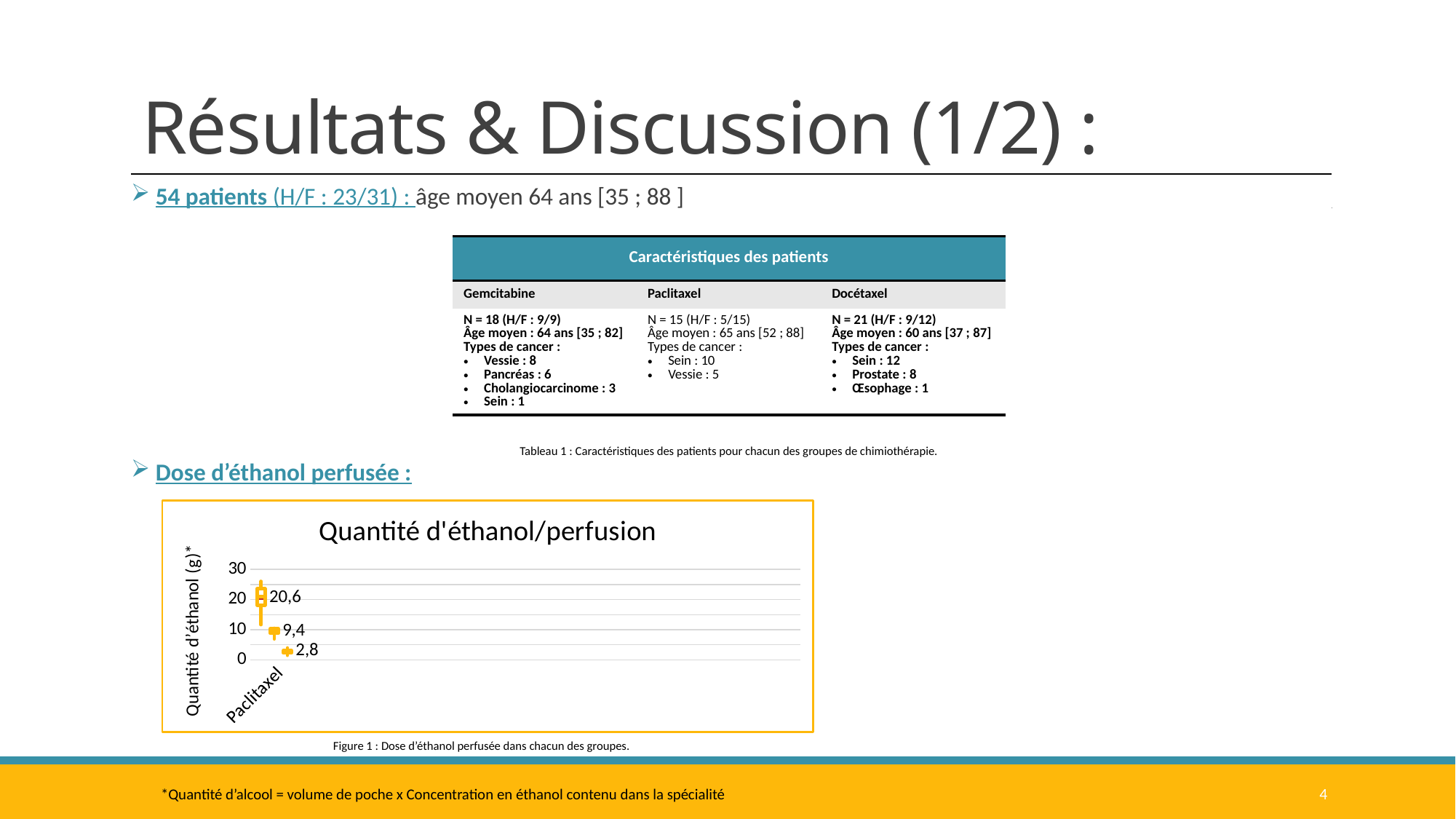
What is the difference between the labeled values of the middle box (9,4) and the rightmost box (2,8)? 6,6 Which box has the larger labeled value, the leftmost box or the rightmost box? The leftmost box How many boxes are plotted in the chart? 3 What value is labeled on the middle box of the chart? 9,4 What is the highest value labeled on the chart? 20,6 What kind of chart is shown on the slide? Box plot What is the label of the y axis of the chart? Quantité d'éthanol (g)* What is the lowest value labeled on the chart? 2,8 What value is labeled on the leftmost box of the chart? 20,6 Do the labeled values rise or fall from left to right across the chart? Fall What is the title of the chart on the slide? Quantité d'éthanol/perfusion What is the difference between the labeled values of the leftmost box (20,6) and the middle box (9,4)? 11,2